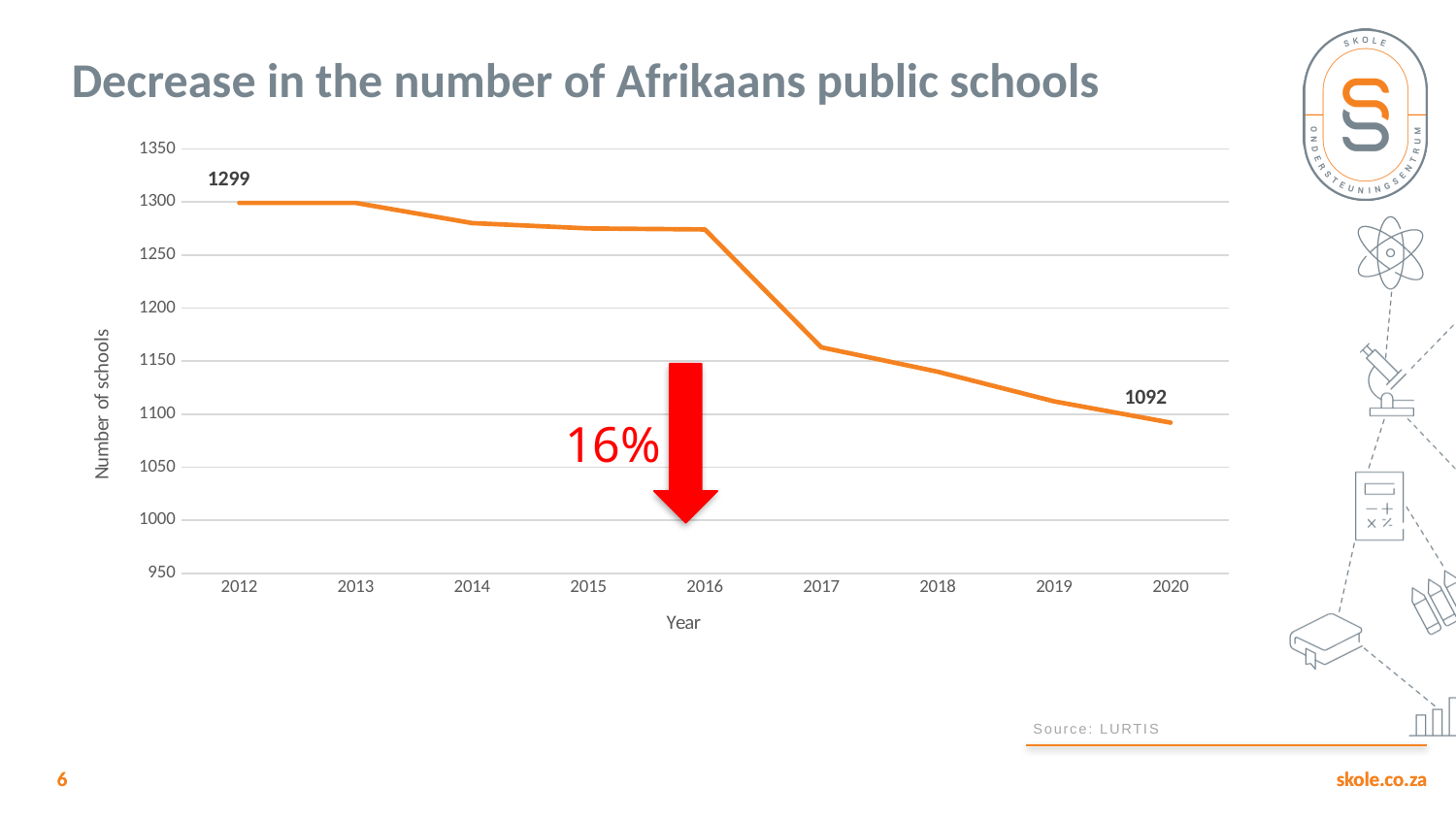
What is the number of Afrikaans public schools shown for 2012? 1299 How many years are plotted on the x axis? 9 Which year has the lowest number of Afrikaans public schools? 2020 What is the number of Afrikaans public schools shown for 2020? 1092 Is the value for 2019 greater or less than 1150? less What kind of chart is shown on the slide? Line chart Which year has more Afrikaans public schools, 2012 or 2020? 2012 Is the value for 2017 greater or less than 1200? less Is the value for 2016 greater or less than 1250? greater Do the values rise or fall from 2012 to 2020? Fall What is the difference between the number of schools in 2012 and in 2020? 207 What percentage decrease is annotated on the chart with the red arrow? 16%